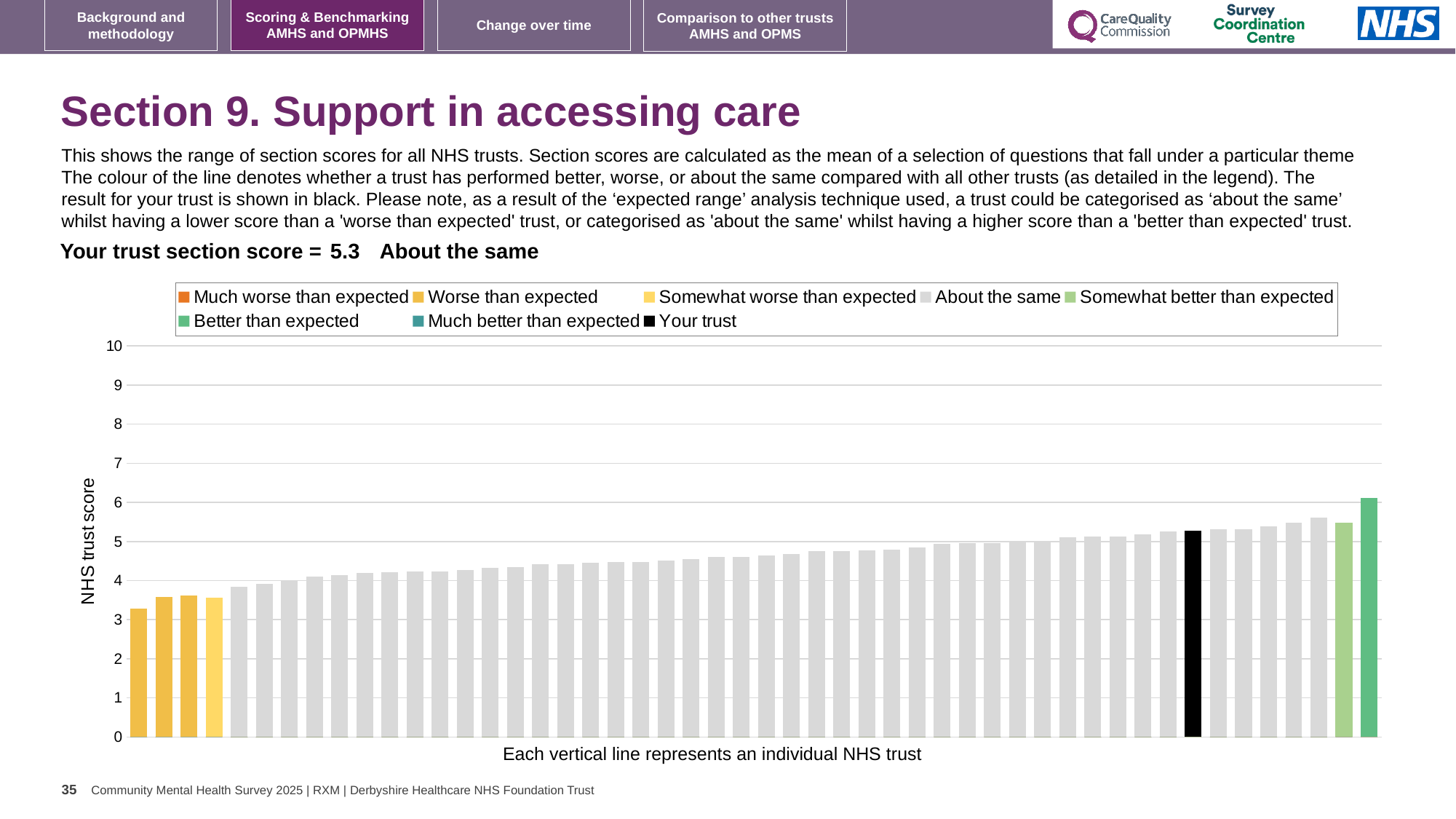
Is the value of the lowest bar greater or less than 4? less How many bars are coloured green? 2 What kind of chart is shown on the slide? bar chart Is the value of the tallest bar greater or less than 5? greater Is your trust's bar higher or lower than the tallest bar in the chart? lower How many entries does the chart legend list? 8 What is the label on the vertical axis? NHS trust score Which category is your trust placed in for this section? About the same Is the value for your trust greater or less than 5? greater Do the bar values rise or fall from left to right along the x axis? rise What is the section score for your trust? 5.3